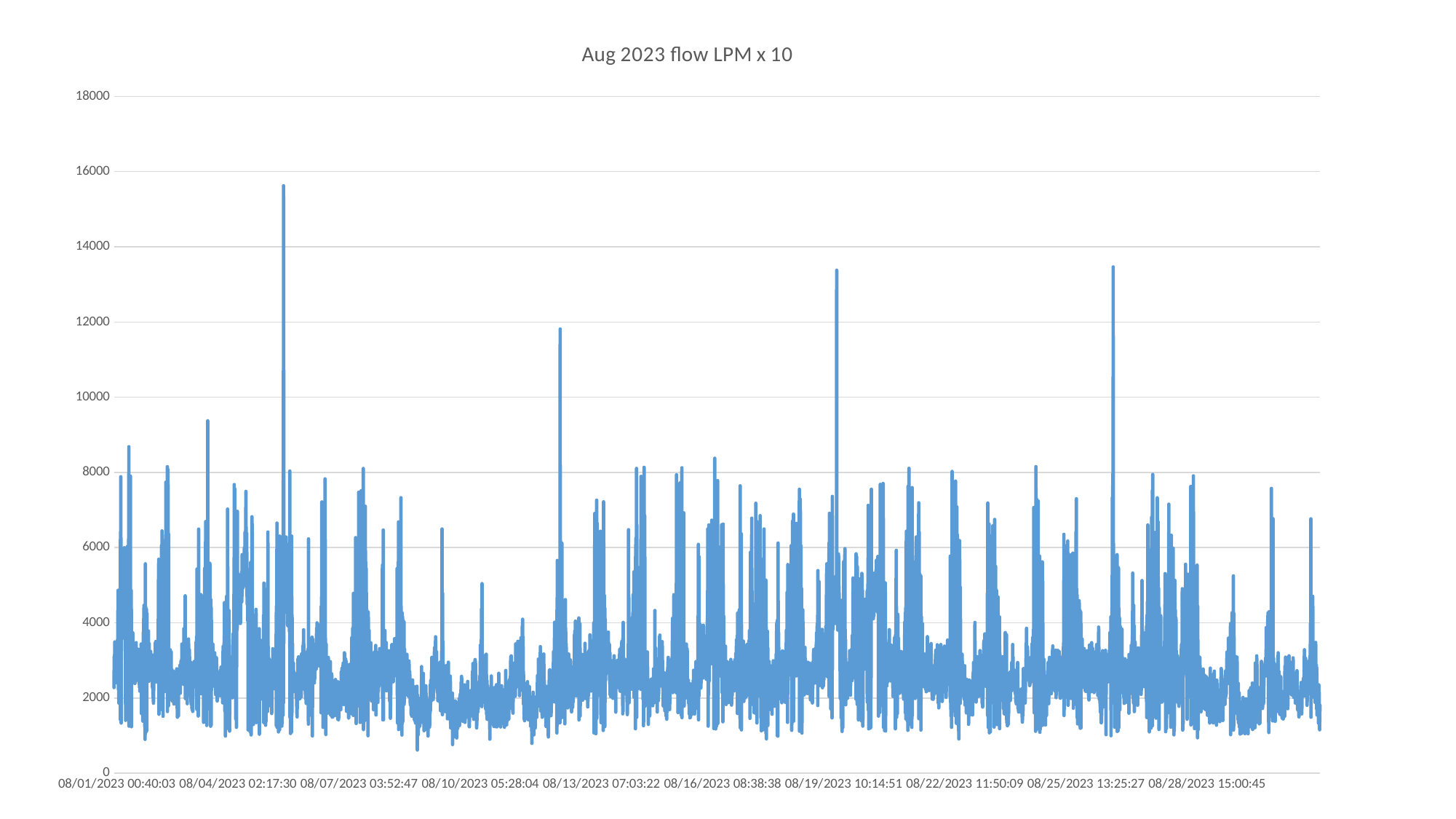
Is the tallest spike near 08/04/2023 greater or less than 12000? greater Is the highest peak on the chart greater or less than 16000? less Is the spike near 08/13/2023 greater or less than 10000? greater What is the last date label on the horizontal axis? 08/28/2023 15:00:45 What kind of chart is shown on the slide? line chart What is the interval between consecutive tick labels on the vertical axis? 2000 What is the title of the chart? Aug 2023 flow LPM x 10 What is the first date label on the horizontal axis? 08/01/2023 00:40:03 What is the highest value shown on the vertical axis? 18000 How many date labels are printed along the horizontal axis? 10